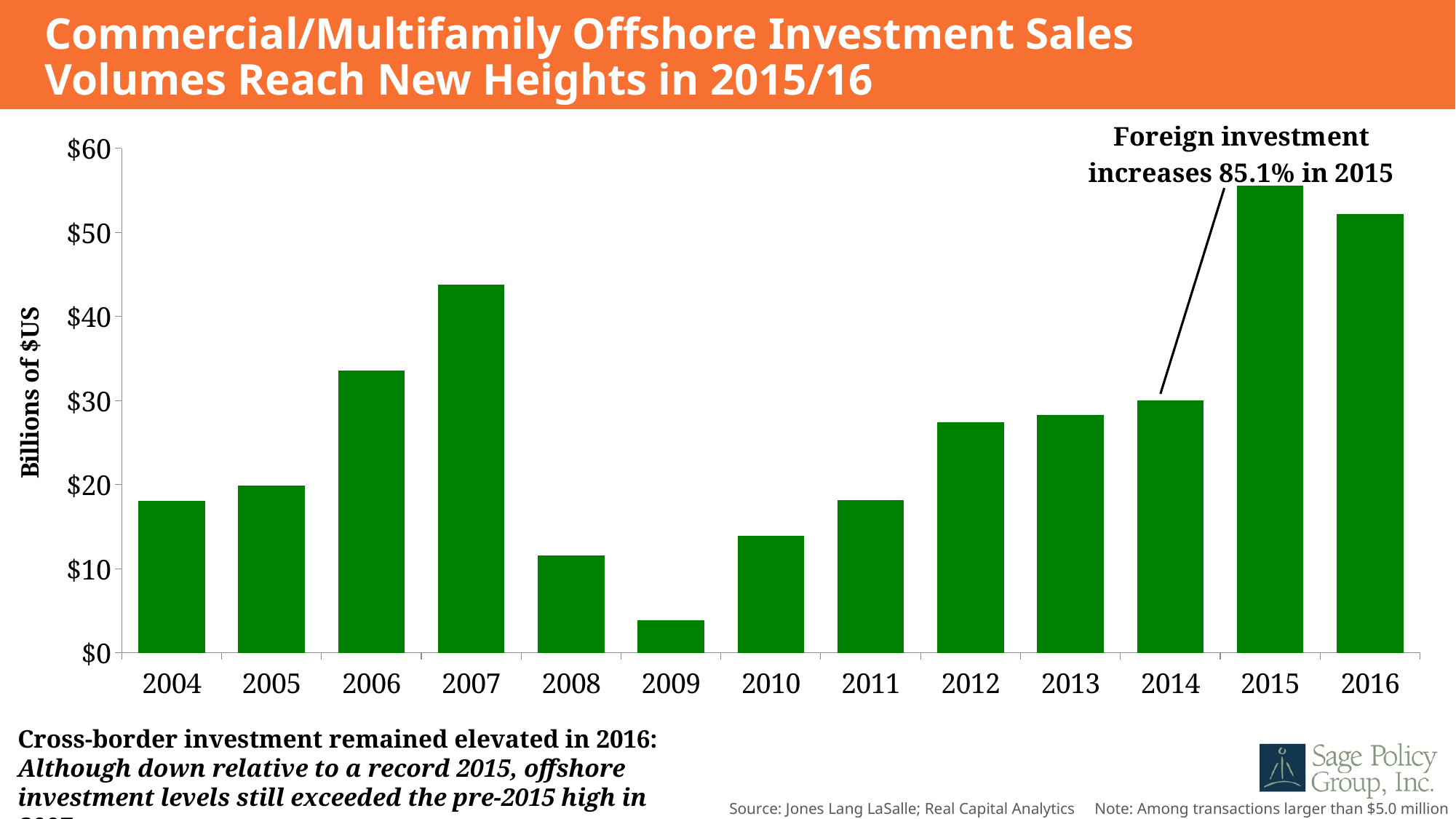
Is the value for 2015 greater or less than $50? greater Which year has a larger value, 2006 or 2012? 2006 Do the values rise or fall from 2004 to 2007? Rise Is the value for 2009 greater or less than $10? less How many years are plotted on the x axis? 13 Which year has a larger value, 2007 or 2016? 2016 What type of chart is shown on the slide? Bar chart Is the value for 2012 greater or less than $30? less Which year has the highest offshore investment sales volume? 2015 What is the label on the y axis? Billions of $US Which year has the lowest offshore investment sales volume? 2009